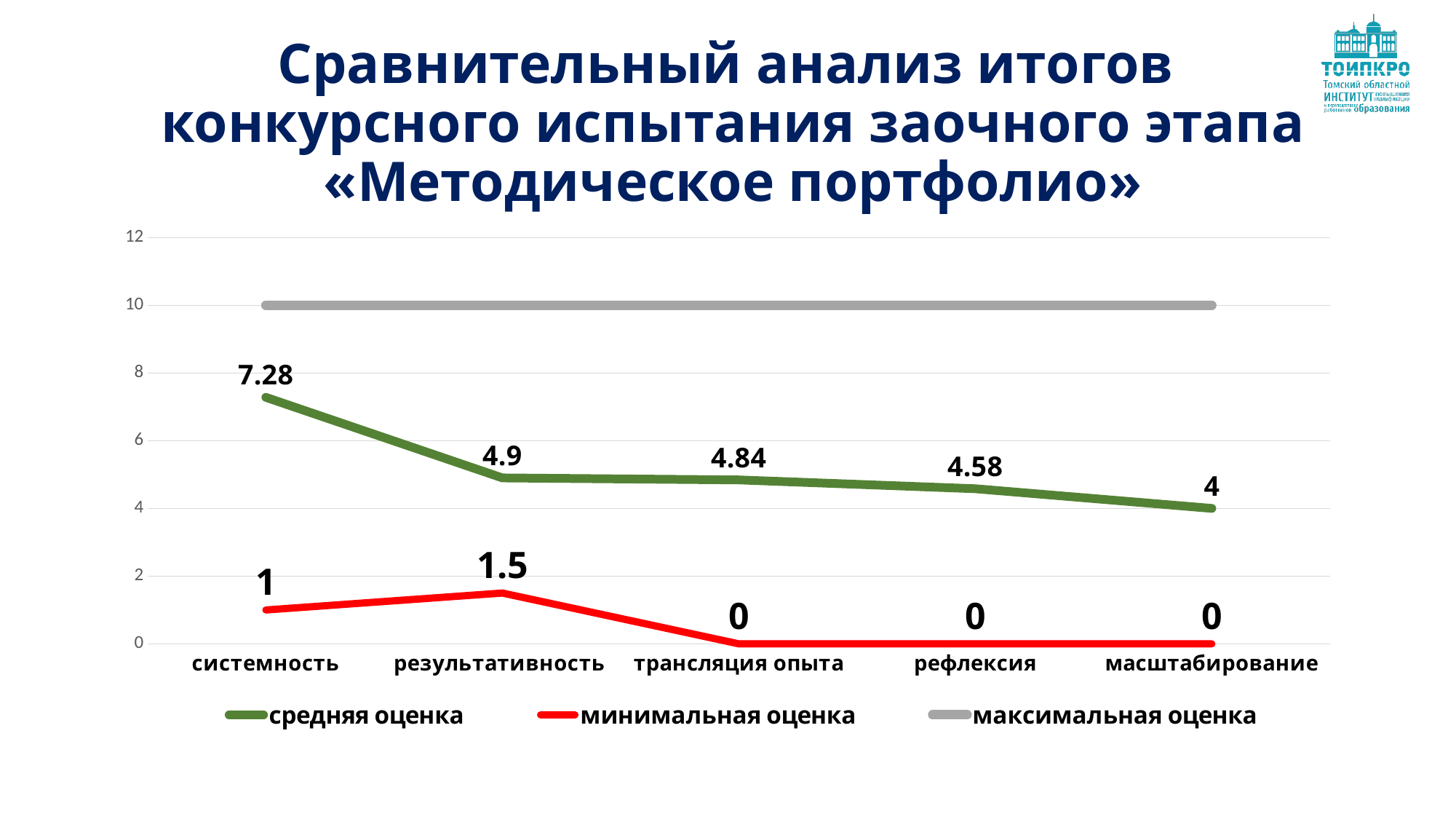
What is the difference between the average score for системность and the average score for масштабирование? 3.28 How many series does the legend list? 3 What kind of chart is shown on the slide? line chart Which is larger: the average score for результативность or the average score for трансляция опыта? результативность What is the minimum score (минимальная оценка) for трансляция опыта? 0 Does the average score (средняя оценка) rise or fall from системность to масштабирование? fall Which category has the highest average score (средняя оценка)? системность How many categories are shown on the x axis? 5 Which category has the lowest average score (средняя оценка)? масштабирование What is the average score (средняя оценка) for рефлексия? 4.58 What is the minimum score (минимальная оценка) for результативность? 1.5 What is the average score (средняя оценка) for системность? 7.28